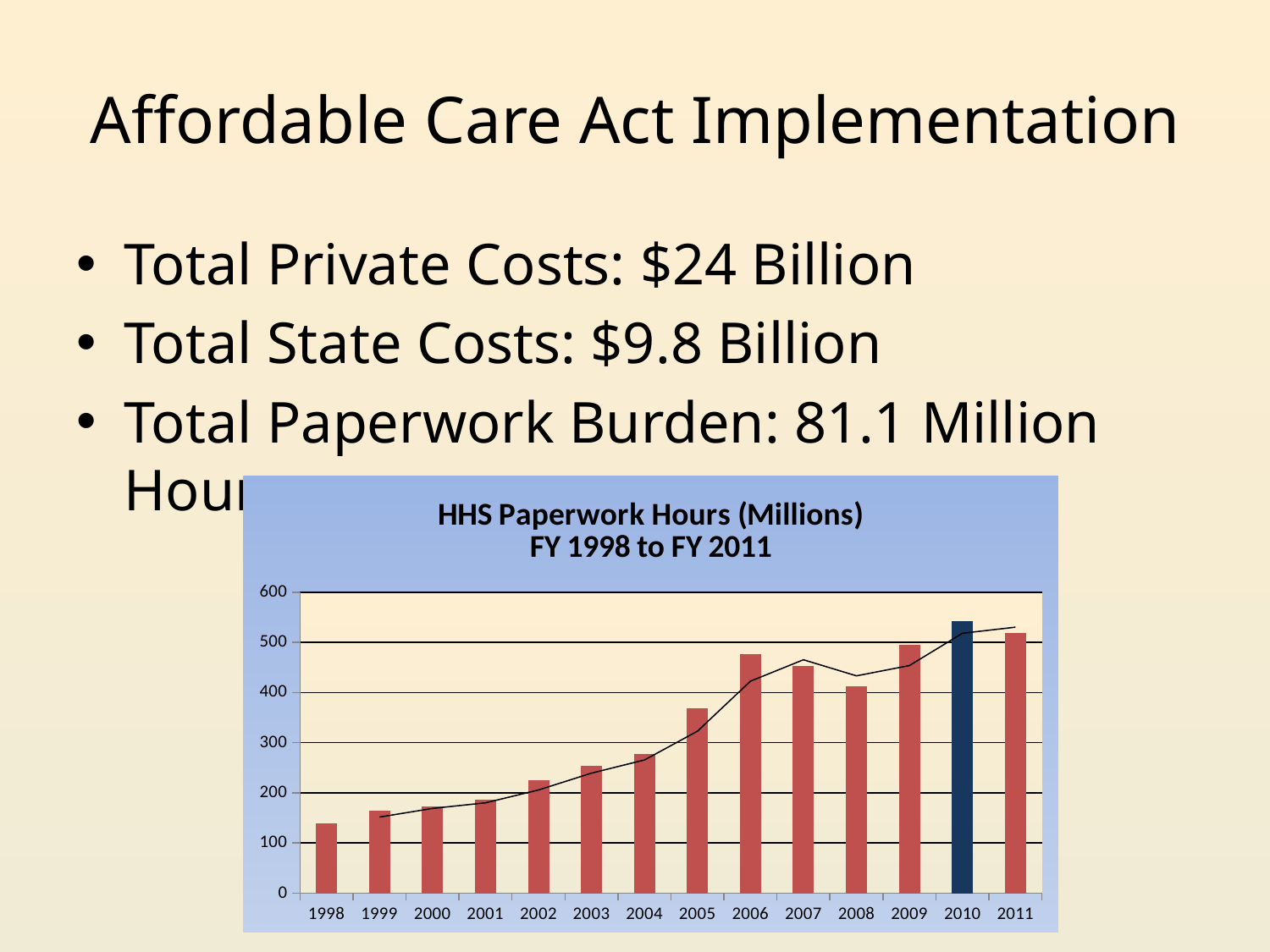
Is the value for 2010 greater or less than 500? greater Which year has the tallest bar in the chart? 2010 What is the title of the chart? HHS Paperwork Hours (Millions) FY 1998 to FY 2011 Is the value for 1998 greater or less than 200? less Is the value for 2008 greater or less than 500? less Which is larger, the bar for 2006 or the bar for 2008? 2006 Which year has the shortest bar in the chart? 1998 How many fiscal years are shown on the x axis of the chart? 14 What kind of chart is shown on the slide? bar chart with a line overlay Do the bar values generally rise or fall from 1998 to 2011? rise Which year's bar is coloured dark blue instead of red? 2010